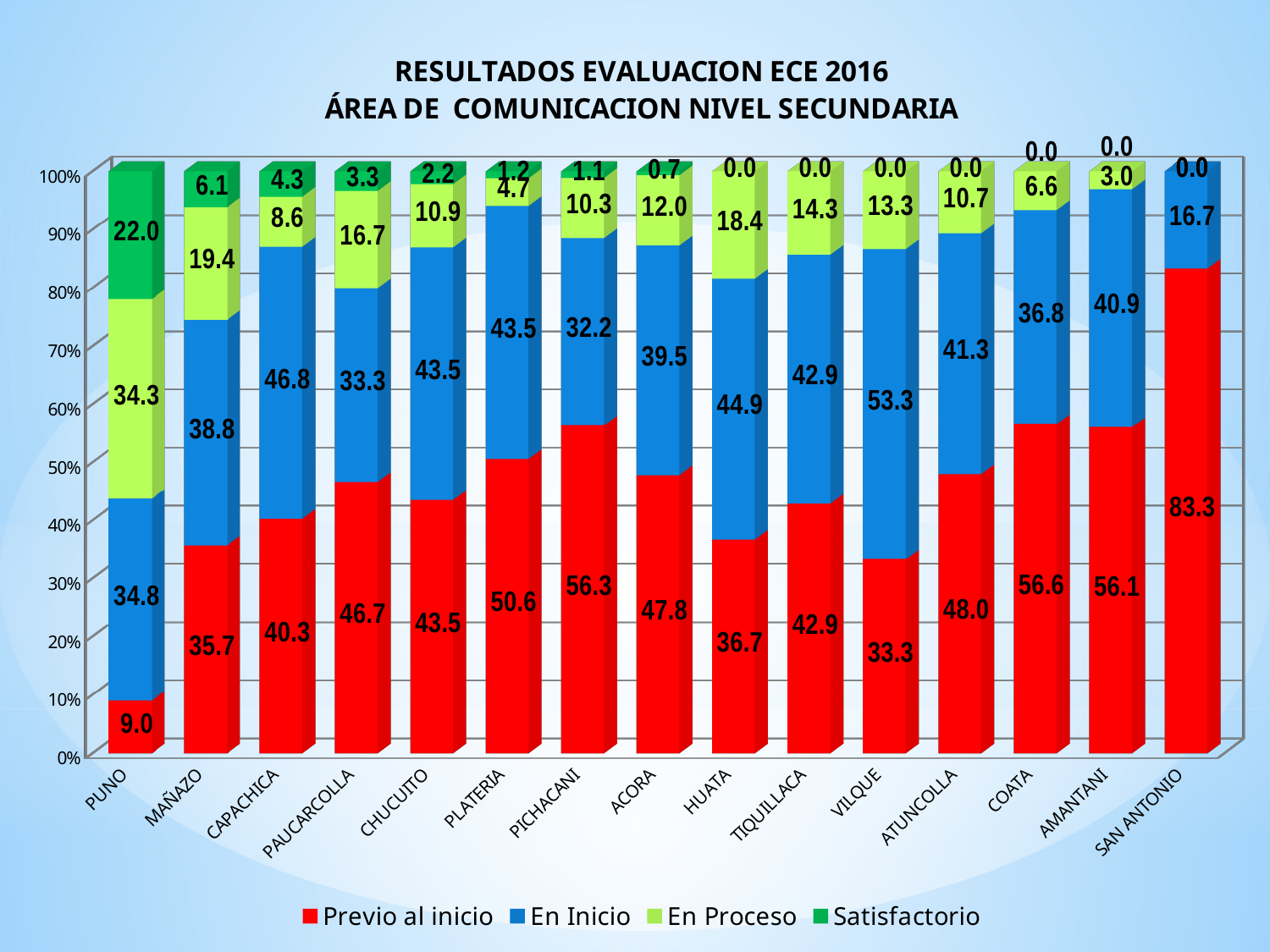
Which category has the lowest Previo al inicio value? PUNO What is the En Proceso value for MAÑAZO? 19.4 What kind of chart is shown on the slide? Stacked bar chart What is the difference between the Previo al inicio values for PICHACANI and HUATA? 19.6 What is the Previo al inicio value for SAN ANTONIO? 83.3 What is the En Inicio value for VILQUE? 53.3 Which category has the highest Previo al inicio value? SAN ANTONIO Which is larger, the En Inicio value for CAPACHICA or for PAUCARCOLLA? CAPACHICA Which series is shown in red in the legend? Previo al inicio How many categories are shown on the x axis? 15 How many series does the legend list? 4 What is the Satisfactorio value for PUNO? 22.0